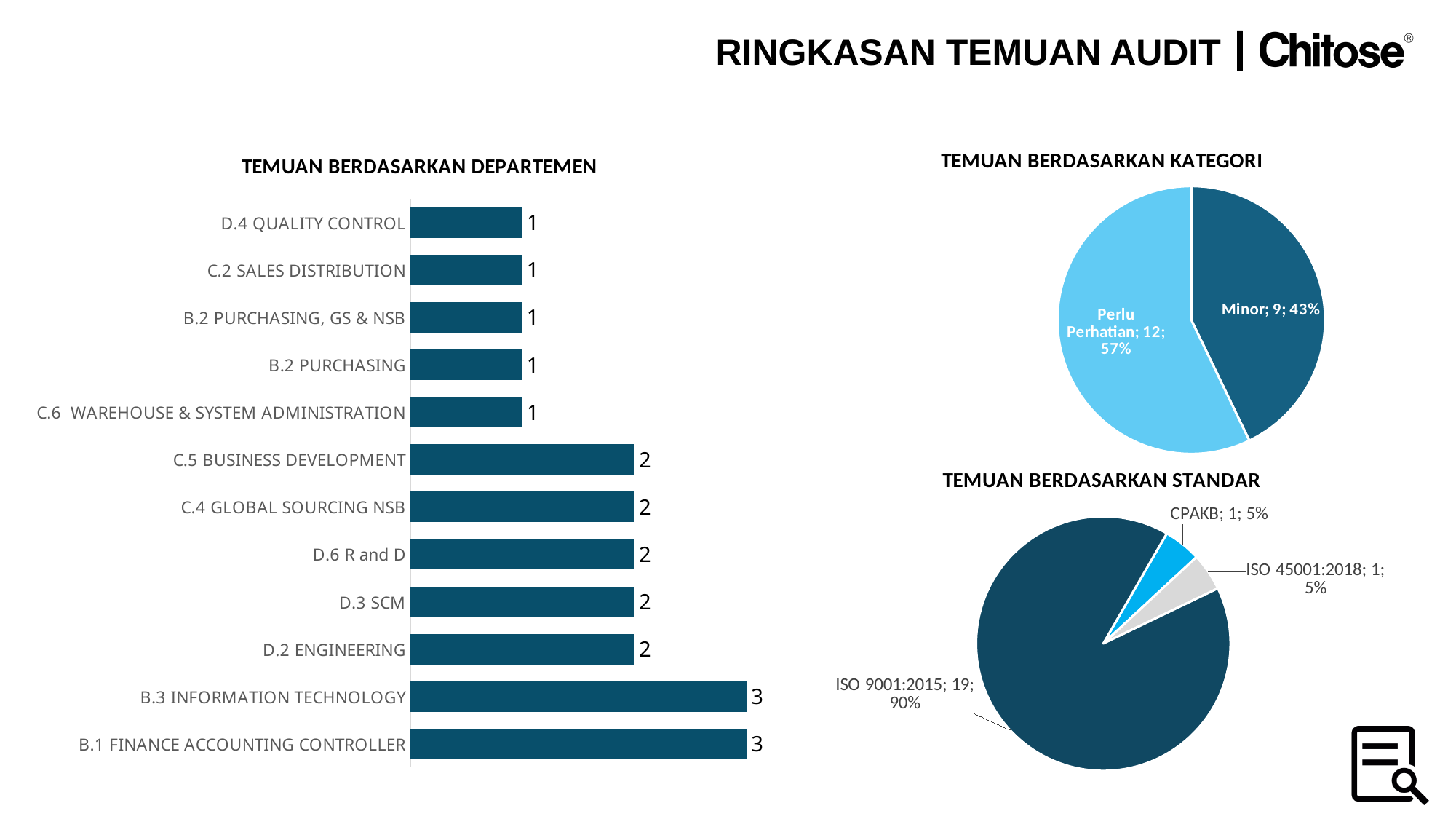
What kind of chart is 'TEMUAN BERDASARKAN DEPARTEMEN'? Bar chart In the 'TEMUAN BERDASARKAN KATEGORI' chart, what is the count for Minor? 9 In the 'TEMUAN BERDASARKAN KATEGORI' chart, what share does Perlu Perhatian have? 57% In the 'TEMUAN BERDASARKAN STANDAR' chart, what share does ISO 9001:2015 have? 90% In the 'TEMUAN BERDASARKAN DEPARTEMEN' chart, what is the value for B.3 INFORMATION TECHNOLOGY? 3 In the 'TEMUAN BERDASARKAN KATEGORI' chart, which category is the largest? Perlu Perhatian In the 'TEMUAN BERDASARKAN DEPARTEMEN' chart, what is the difference between B.1 FINANCE ACCOUNTING CONTROLLER and D.4 QUALITY CONTROL? 2 In the 'TEMUAN BERDASARKAN DEPARTEMEN' chart, which is larger, C.5 BUSINESS DEVELOPMENT or B.2 PURCHASING? C.5 BUSINESS DEVELOPMENT In the 'TEMUAN BERDASARKAN DEPARTEMEN' chart, how many departments are listed? 12 In the 'TEMUAN BERDASARKAN DEPARTEMEN' chart, what is the value for D.3 SCM? 2 What kind of chart is 'TEMUAN BERDASARKAN STANDAR'? Pie chart In the 'TEMUAN BERDASARKAN STANDAR' chart, how many slices are there? 3